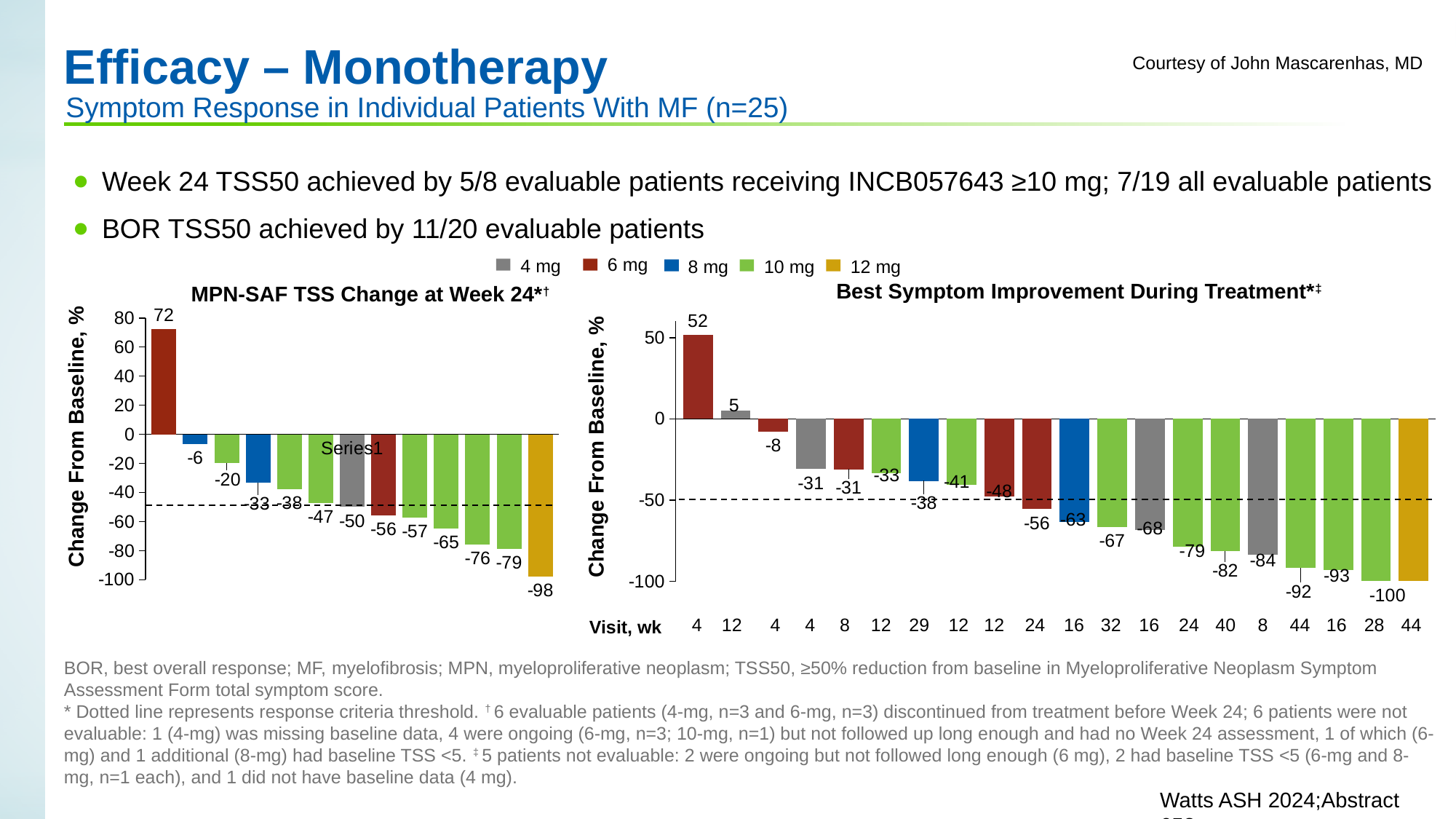
In the Best Symptom Improvement During Treatment chart, what is the highest value shown? 52 In the MPN-SAF TSS Change at Week 24 chart, which is larger, the bar labeled -47 or the bar labeled -76? -47 In the Best Symptom Improvement During Treatment chart, what is the value of the second bar from the left? 5 What type of chart is used on this slide? bar chart What is the title of the right-hand chart? Best Symptom Improvement During Treatment In the MPN-SAF TSS Change at Week 24 chart, do the values rise or fall moving from left to right? fall In the MPN-SAF TSS Change at Week 24 chart, what is the lowest value shown? -98 How many bars are plotted in the MPN-SAF TSS Change at Week 24 chart? 13 How many dose groups does the legend list? 5 In the Best Symptom Improvement During Treatment chart, what is the lowest value shown? -100 In the Best Symptom Improvement During Treatment chart, what is the difference between the two positive values, 52 and 5? 47 In the MPN-SAF TSS Change at Week 24 chart, what is the highest value shown? 72